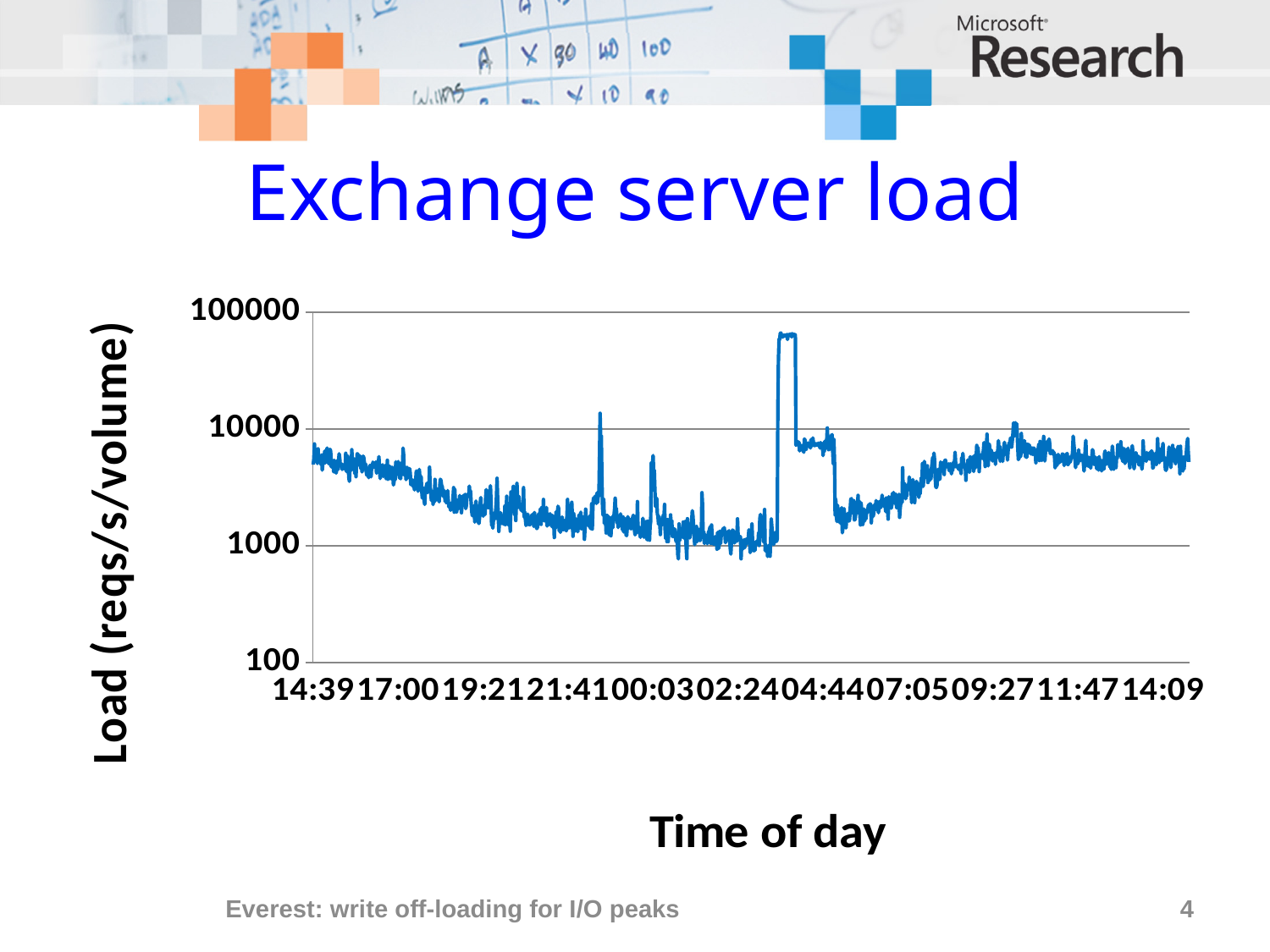
Is the load at the end of the trace (14:09) greater or less than 1000? greater Is the load at the start of the trace (14:39) greater or less than 1000? greater What is the label of the y axis? Load (reqs/s/volume) What kind of chart is shown on the slide? line chart Does the load generally rise or fall between 07:05 and 11:47? rise Is the load at the start of the trace (14:39) greater or less than 10000? less Near which x-axis time label does the load reach its highest value? 04:44 What is the title of the chart on the slide? Exchange server load Does the load generally rise or fall between 14:39 and 00:03? fall How many time labels are shown along the x axis? 11